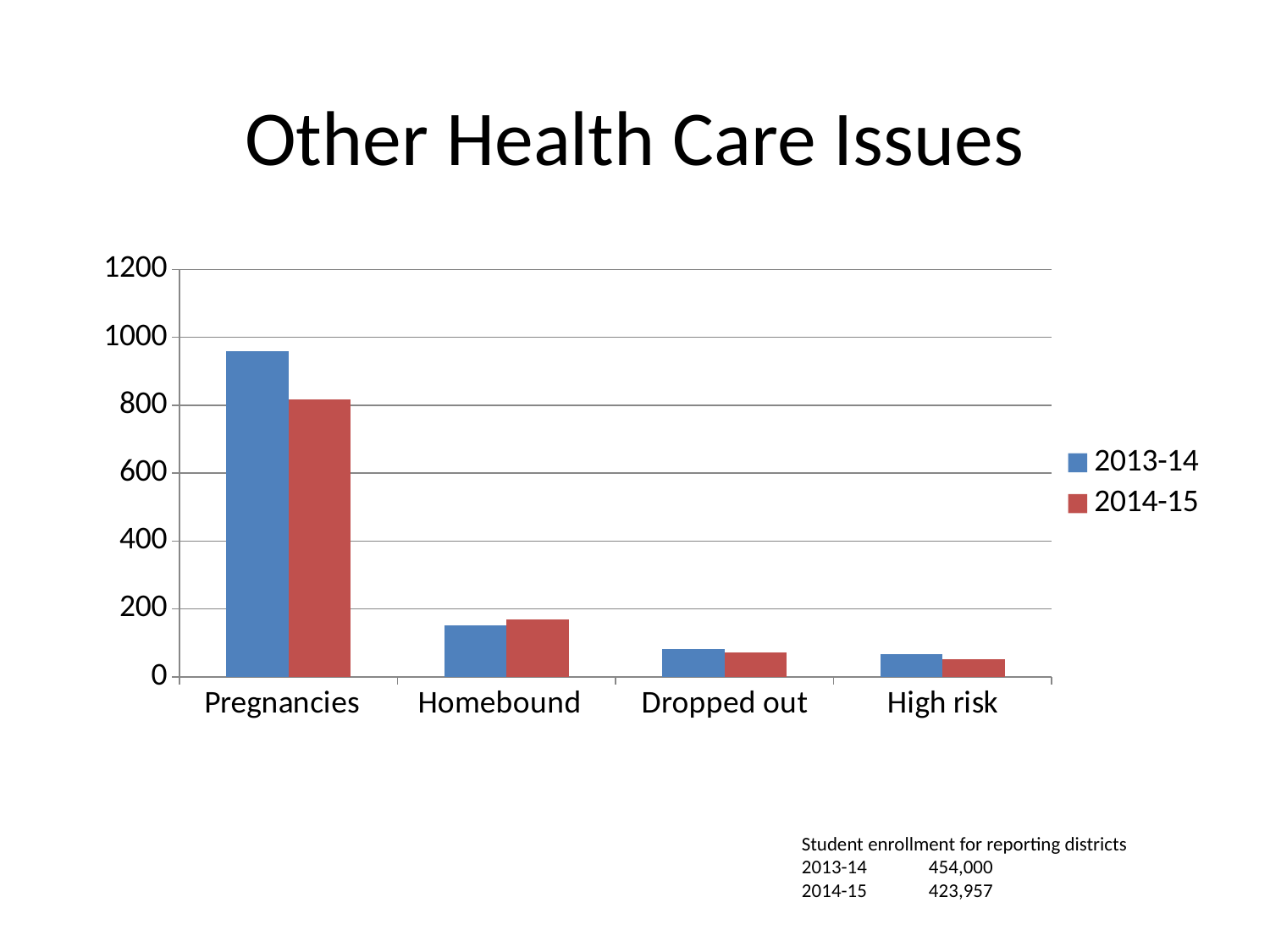
Do the 2014-15 values rise or fall moving from Pregnancies to High risk along the x axis? fall Which category has the lowest value for 2014-15? High risk What is the title of the chart? Other Health Care Issues What kind of chart is shown on the slide? bar chart Is the 2013-14 value for Pregnancies greater or less than 800? greater How many categories are shown on the x axis? 4 For Pregnancies, which series has the larger value, 2013-14 or 2014-15? 2013-14 Which category has the highest value for 2013-14? Pregnancies How many series does the legend list? 2 Is the 2014-15 value for Pregnancies greater or less than 1000? less For Homebound, which series has the larger value, 2013-14 or 2014-15? 2014-15 Is the 2014-15 value for Homebound greater or less than 200? less